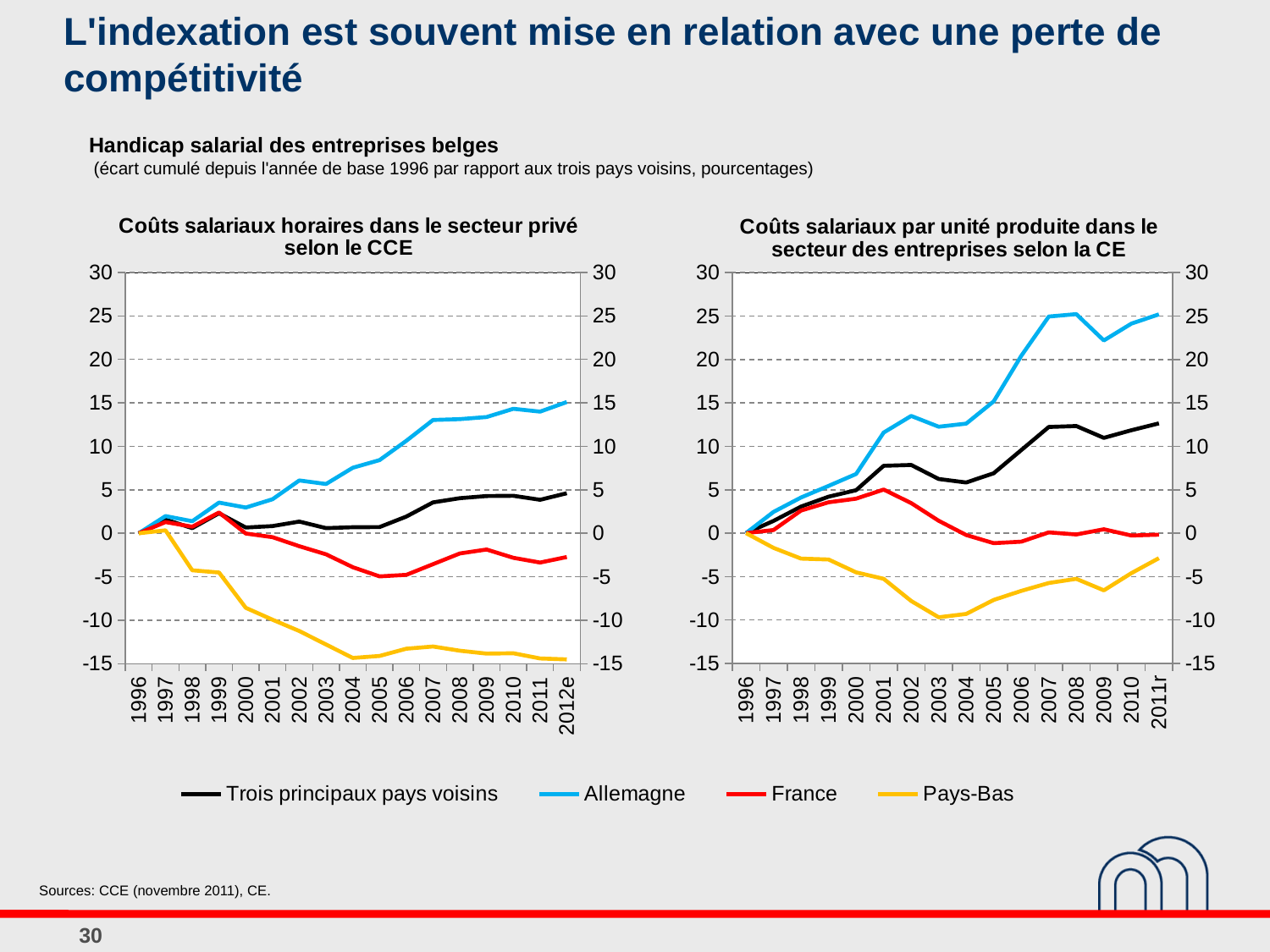
In the left chart, 'Coûts salariaux horaires dans le secteur privé selon le CCE', is the value for Allemagne in 2012e greater or less than 10? greater In the right chart, 'Coûts salariaux par unité produite dans le secteur des entreprises selon la CE', is the value for Allemagne in 2007 greater or less than 20? greater In the right chart, 'Coûts salariaux par unité produite dans le secteur des entreprises selon la CE', is the value for Pays-Bas in 2003 greater or less than -5? less In the left chart, 'Coûts salariaux horaires dans le secteur privé selon le CCE', how many years are shown on the x axis? 17 What kind of chart is the left chart, 'Coûts salariaux horaires dans le secteur privé selon le CCE'? line chart In the right chart, 'Coûts salariaux par unité produite dans le secteur des entreprises selon la CE', which series has the highest value in 2011r? Allemagne How many series does the shared legend list? 4 In the right chart, 'Coûts salariaux par unité produite dans le secteur des entreprises selon la CE', which is larger in 2011r: Allemagne or Trois principaux pays voisins? Allemagne In the left chart, 'Coûts salariaux horaires dans le secteur privé selon le CCE', does the Allemagne series generally rise or fall from 1996 to 2012e? rise In the left chart, 'Coûts salariaux horaires dans le secteur privé selon le CCE', which series has the highest value in 2012e? Allemagne In the left chart, 'Coûts salariaux horaires dans le secteur privé selon le CCE', which series has the lowest value in 2012e? Pays-Bas In the right chart, 'Coûts salariaux par unité produite dans le secteur des entreprises selon la CE', how many years are shown on the x axis? 16